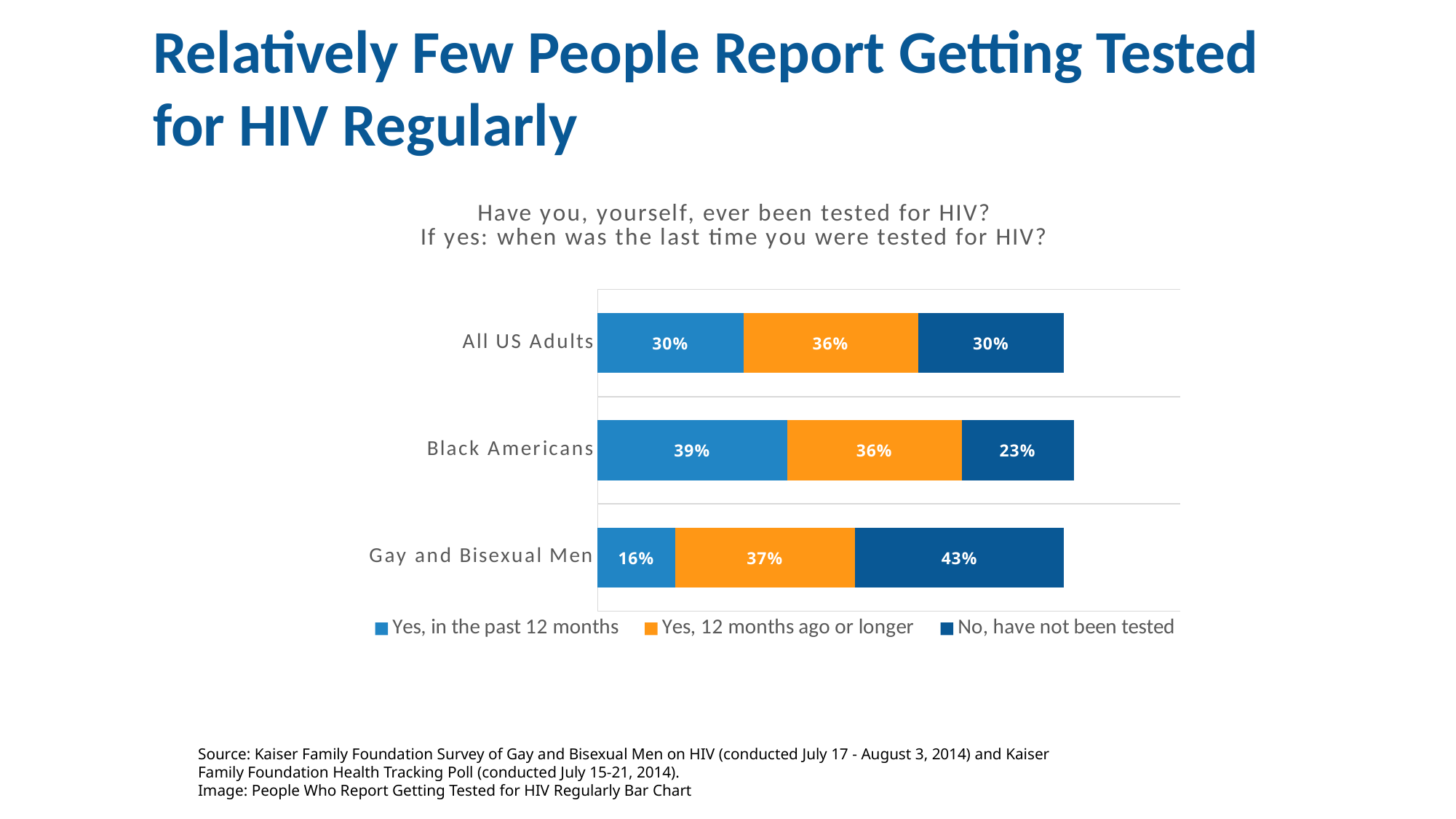
Is the 'Yes, in the past 12 months' share larger for All US Adults or for Gay and Bisexual Men? All US Adults Which group has the highest share reporting 'No, have not been tested'? Gay and Bisexual Men How many series does the legend list? 3 What percentage of All US Adults report being tested for HIV in the past 12 months? 30% What percentage of Gay and Bisexual Men report being tested for HIV 12 months ago or longer? 37% How many groups are shown in the chart? 3 Which group has the lowest share reporting 'Yes, in the past 12 months'? Gay and Bisexual Men What is the difference between the 'No, have not been tested' share for Gay and Bisexual Men and for Black Americans? 20 percentage points Which group has the highest share reporting 'Yes, in the past 12 months'? Black Americans What is the total of the three segments in the Black Americans bar? 98% What percentage of Black Americans report having not been tested for HIV? 23% What kind of chart is shown on the slide? Stacked bar chart